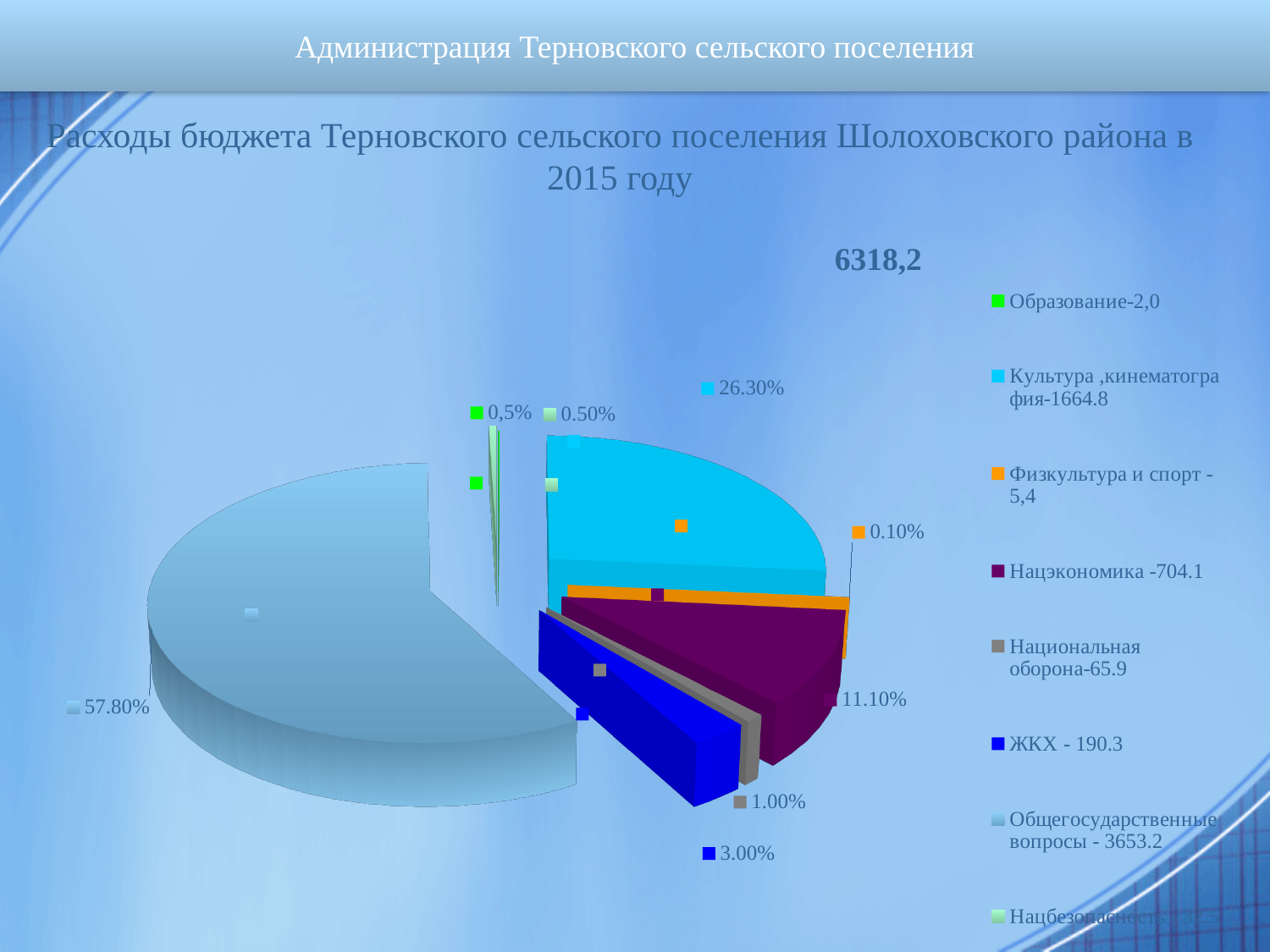
What is the difference in percentage points between the Общегосударственные вопросы slice and the Культура, кинематография slice? 31.50% Which category has the largest slice of the pie? Общегосударственные вопросы What percentage share is labelled for the ЖКХ slice? 3.00% Which slice is larger: Культура, кинематография or Нацэкономика? Культура, кинематография What percentage share is labelled for the Национальная оборона slice? 1.00% What percentage share is labelled for the Культура, кинематография slice? 26.30% What percentage share is labelled for the Общегосударственные вопросы slice? 57.80% What percentage share is labelled for the Физкультура и спорт slice? 0.10% What percentage share is labelled for the Нацэкономика slice? 11.10% How many entries does the legend list? 8 What type of chart is shown on the slide? pie chart What amount is shown in the legend for ЖКХ? 190.3